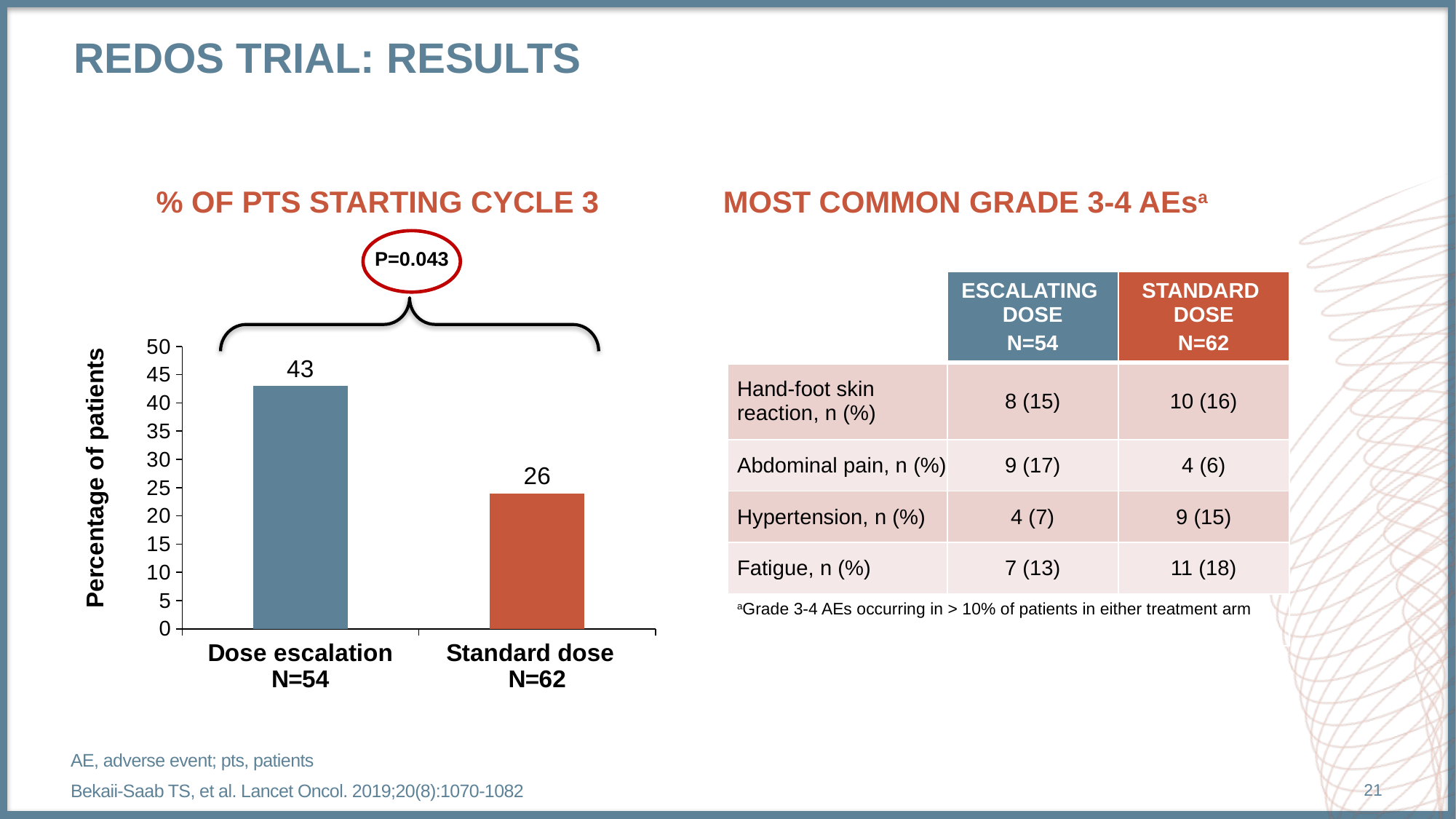
Which category has the highest value in the '% of pts starting cycle 3' chart? Dose escalation What is the y-axis label of the '% of pts starting cycle 3' chart? Percentage of patients What P value is shown above the bars in the '% of pts starting cycle 3' chart? P=0.043 What is the value for Dose escalation in the '% of pts starting cycle 3' chart? 43 Is the value for Dose escalation in the '% of pts starting cycle 3' chart greater or less than 40? greater What kind of chart is the '% of pts starting cycle 3' chart? Bar chart Is the value for Standard dose in the '% of pts starting cycle 3' chart greater or less than 30? less What is the value for Standard dose in the '% of pts starting cycle 3' chart? 26 What is the difference between the Dose escalation and Standard dose values in the '% of pts starting cycle 3' chart? 17 Which category has the lowest value in the '% of pts starting cycle 3' chart? Standard dose In the '% of pts starting cycle 3' chart, which is larger: Dose escalation or Standard dose? Dose escalation How many categories are shown in the '% of pts starting cycle 3' chart? 2